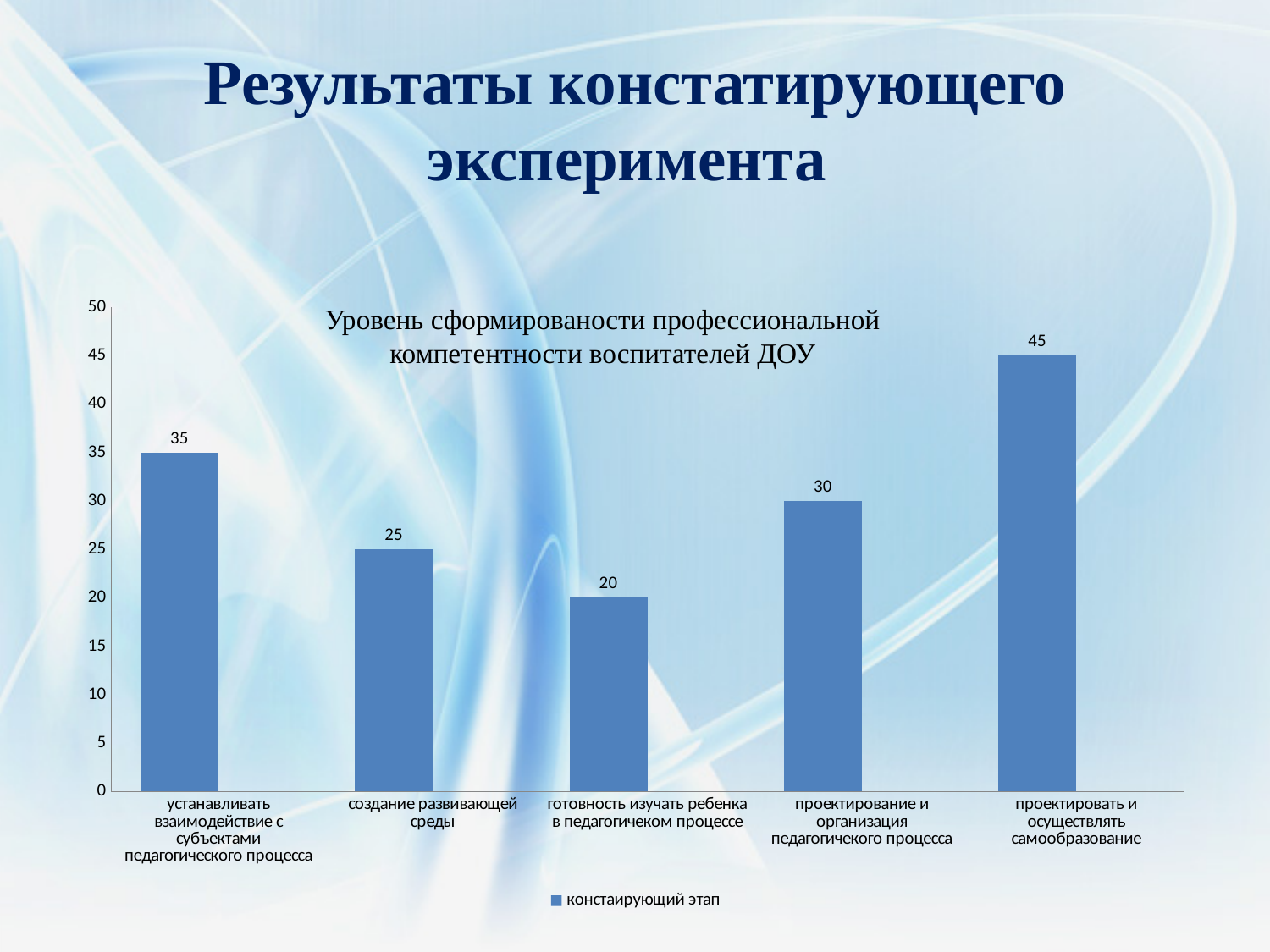
What is the title of the chart? Уровень сформированости профессиональной компетентности воспитателей ДОУ How many series does the legend list? 1 What is the value for "готовность изучать ребенка в педагогичеком процессе"? 20 What is the value for "проектирование и организация педагогичекого процесса"? 30 Which category has the highest value? проектировать и осуществлять самообразование Which is larger: the value for "устанавливать взаимодействие с субъектами педагогического процесса" or for "проектирование и организация педагогичекого процесса"? устанавливать взаимодействие с субъектами педагогического процесса Which category has the lowest value? готовность изучать ребенка в педагогичеком процессе What is the difference between the values for "проектировать и осуществлять самообразование" and "устанавливать взаимодействие с субъектами педагогического процесса"? 10 What is the value for "создание развивающей среды"? 25 How many categories are shown on the x axis? 5 What kind of chart is shown on the slide? bar chart Is the value for "создание развивающей среды" greater or less than 30? less